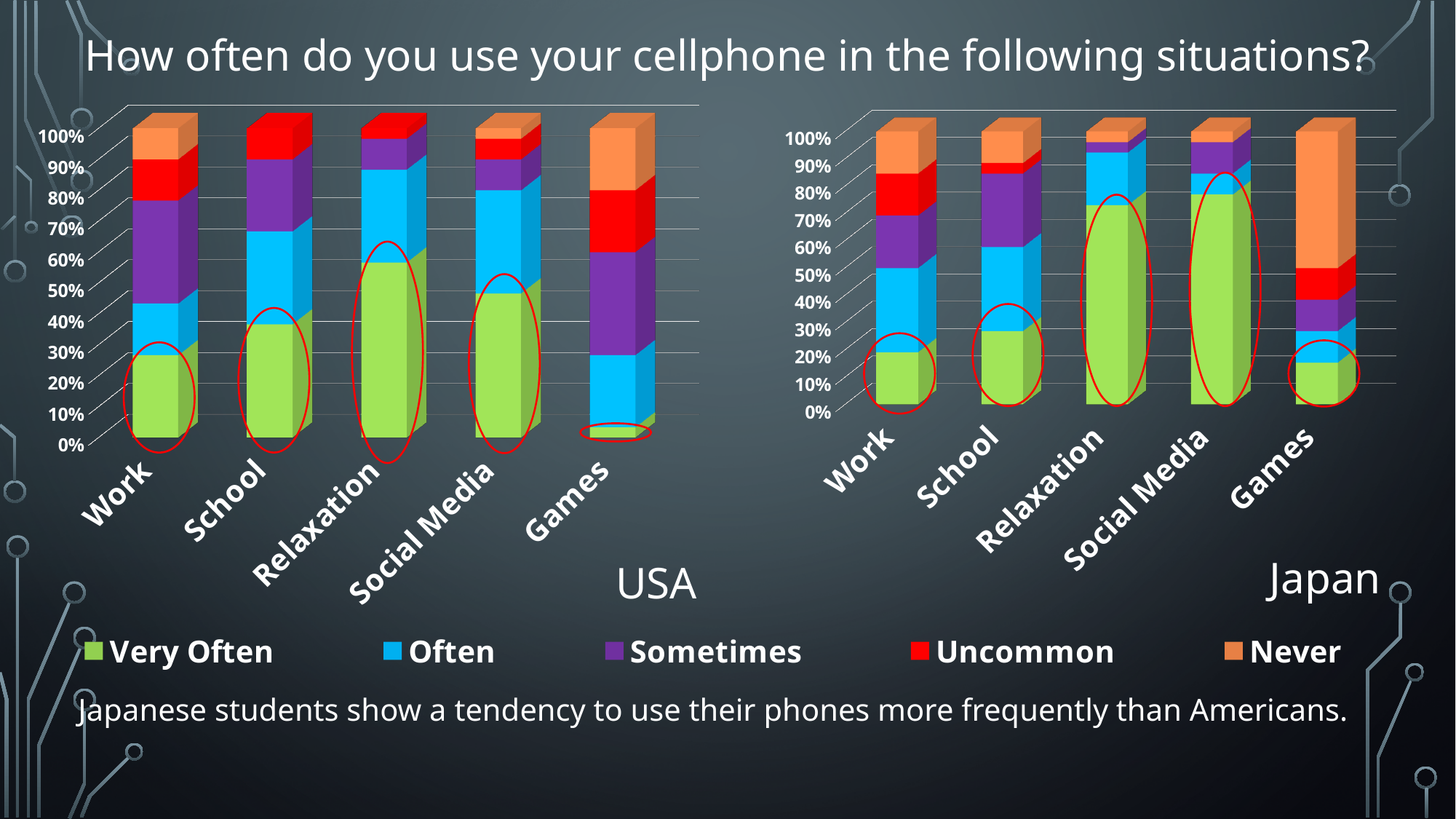
Which colour represents the Never series in the legend? orange In the USA chart, which is larger: the Very Often segment for Relaxation or for School? Relaxation In the USA chart, which category has the largest Very Often segment? Relaxation In the USA chart, is the Very Often value for Relaxation greater or less than 50%? greater How many categories are shown on the x axis of the Japan chart? 5 What kind of chart is the USA chart on the left? bar chart In the Japan chart, is the Very Often value for Social Media greater or less than 70%? greater In the USA chart, which category has the smallest Very Often segment? Games In the USA chart, is the Very Often value for Games greater or less than 10%? less In the Japan chart, which is larger: the Never segment for Games or for Work? Games How many series does the legend list? 5